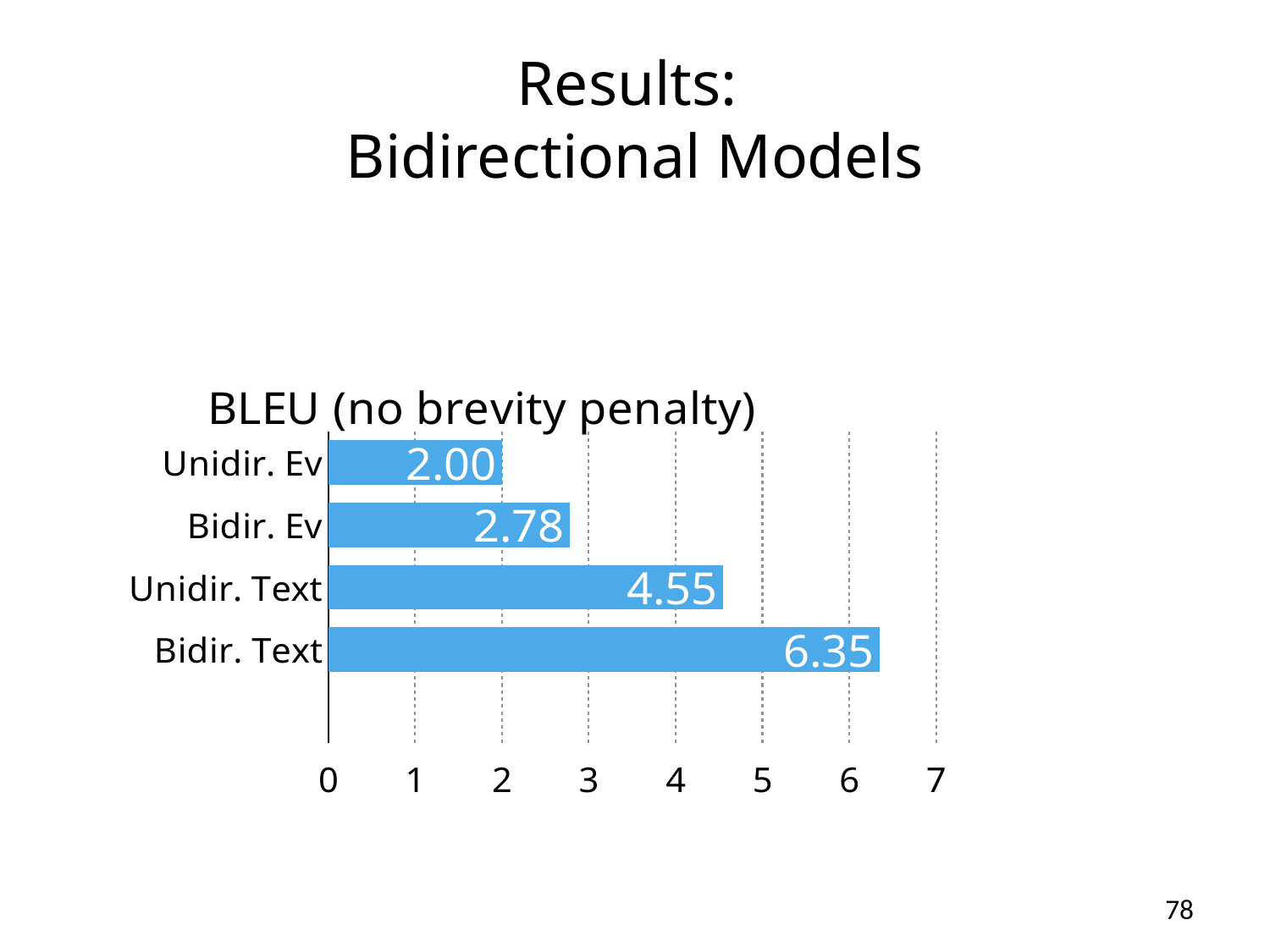
What kind of chart is shown on the slide? bar chart Which category has the lowest BLEU (no brevity penalty) value? Unidir. Ev Which has a larger BLEU value, Unidir. Text or Bidir. Ev? Unidir. Text What is the BLEU (no brevity penalty) value for Unidir. Ev? 2.00 Which category has the highest BLEU (no brevity penalty) value? Bidir. Text What is the BLEU (no brevity penalty) value for Bidir. Text? 6.35 What is the title of the chart? BLEU (no brevity penalty) What is the difference between the BLEU values for Bidir. Ev and Unidir. Ev? 0.78 What is the BLEU (no brevity penalty) value for Bidir. Ev? 2.78 Is the BLEU value for Unidir. Text greater or less than 4? greater What is the difference between the BLEU values for Bidir. Text and Unidir. Text? 1.80 How many categories are shown in the chart? 4